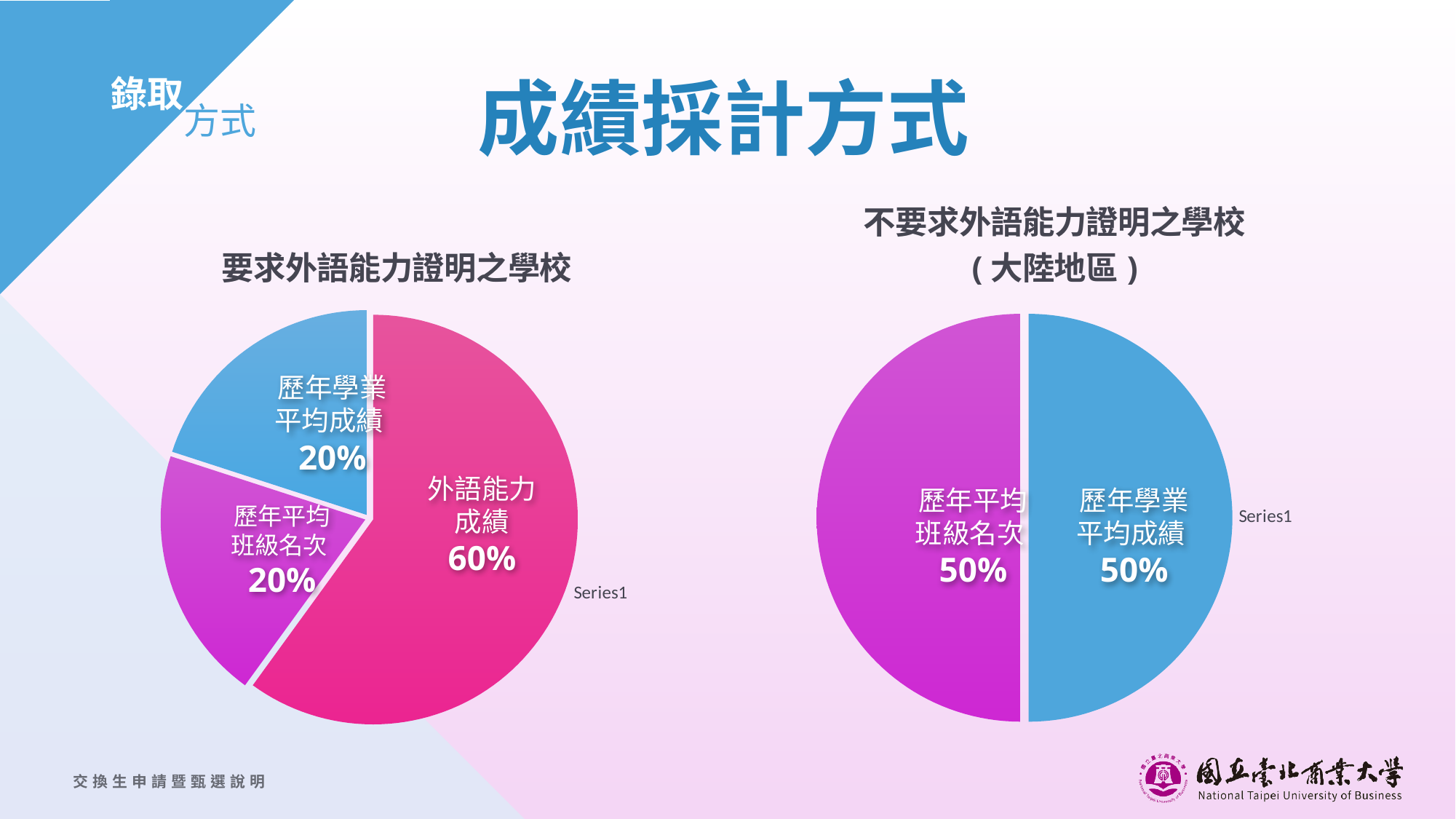
In the left chart titled 要求外語能力證明之學校, what share does 外語能力成績 have? 60% In the right chart titled 不要求外語能力證明之學校（大陸地區）, how many slices does the pie have? 2 In the left chart titled 要求外語能力證明之學校, what colour is the 外語能力成績 slice? Pink What kind of chart is the left chart titled 要求外語能力證明之學校? Pie chart In the left chart titled 要求外語能力證明之學校, what is the difference between the share of 外語能力成績 and the share of 歷年學業平均成績? 40% In the left chart titled 要求外語能力證明之學校, which is larger, 外語能力成績 or 歷年平均班級名次? 外語能力成績 In the left chart titled 要求外語能力證明之學校, which slice is the largest? 外語能力成績 In the right chart titled 不要求外語能力證明之學校（大陸地區）, what share does 歷年學業平均成績 have? 50% In the right chart titled 不要求外語能力證明之學校（大陸地區）, what share does 歷年平均班級名次 have? 50% In the left chart titled 要求外語能力證明之學校, what share does 歷年平均班級名次 have? 20% In the left chart titled 要求外語能力證明之學校, how many slices does the pie have? 3 In the left chart titled 要求外語能力證明之學校, what share does 歷年學業平均成績 have? 20%